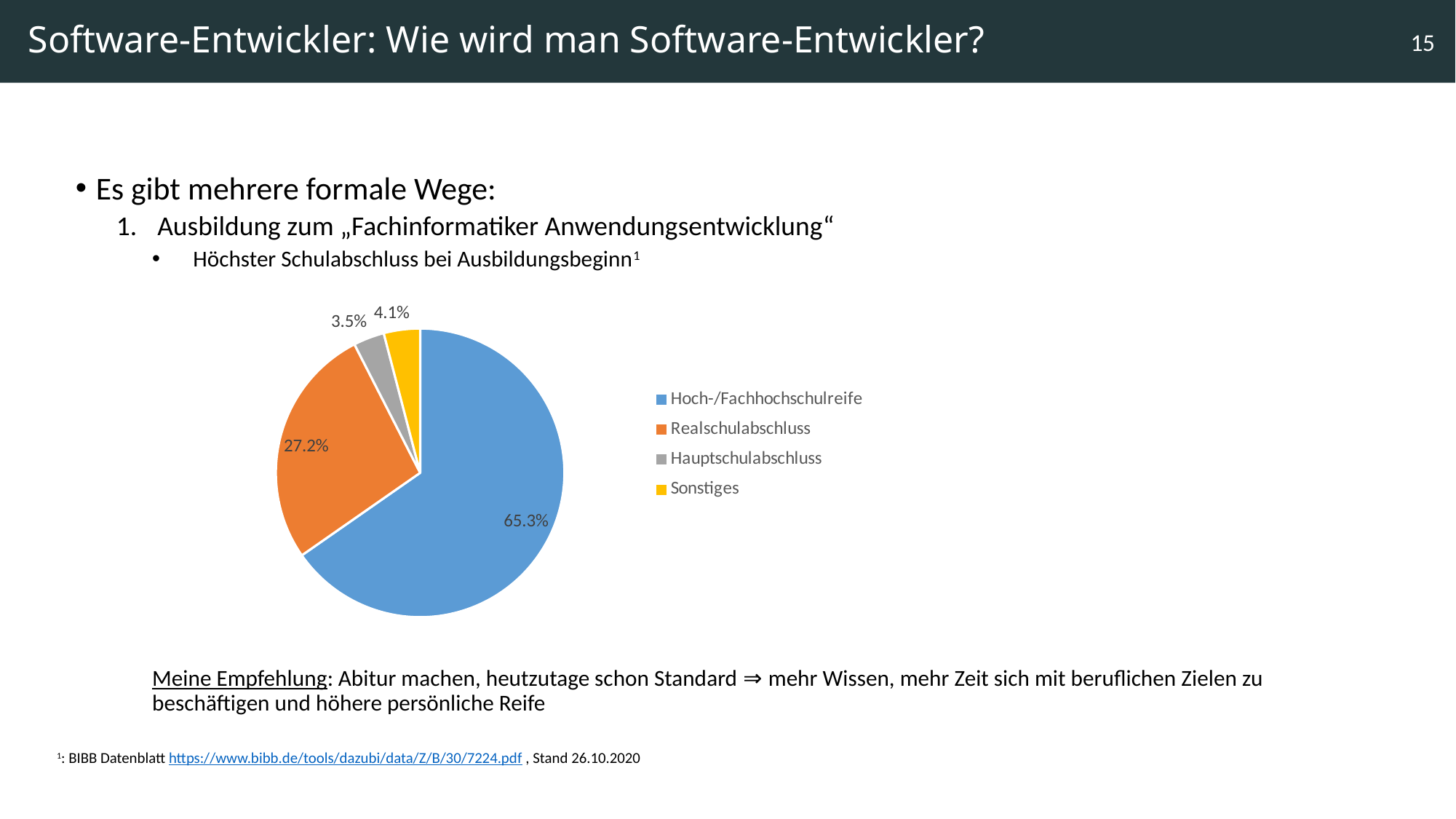
What is the combined share of Hauptschulabschluss and Sonstiges? 7.6% How many categories does the pie chart show? 4 What share of the pie does Hoch-/Fachhochschulreife have? 65.3% What kind of chart is shown on the slide? pie chart What is the difference in percentage points between Hoch-/Fachhochschulreife and Realschulabschluss? 38.1 What share of the pie does Sonstiges have? 4.1% Which colour represents Realschulabschluss in the pie chart? orange Which category has the smallest slice of the pie? Hauptschulabschluss Which category has the largest slice of the pie? Hoch-/Fachhochschulreife What share of the pie does Realschulabschluss have? 27.2% Which is larger, the slice for Sonstiges or the slice for Hauptschulabschluss? Sonstiges What share of the pie does Hauptschulabschluss have? 3.5%